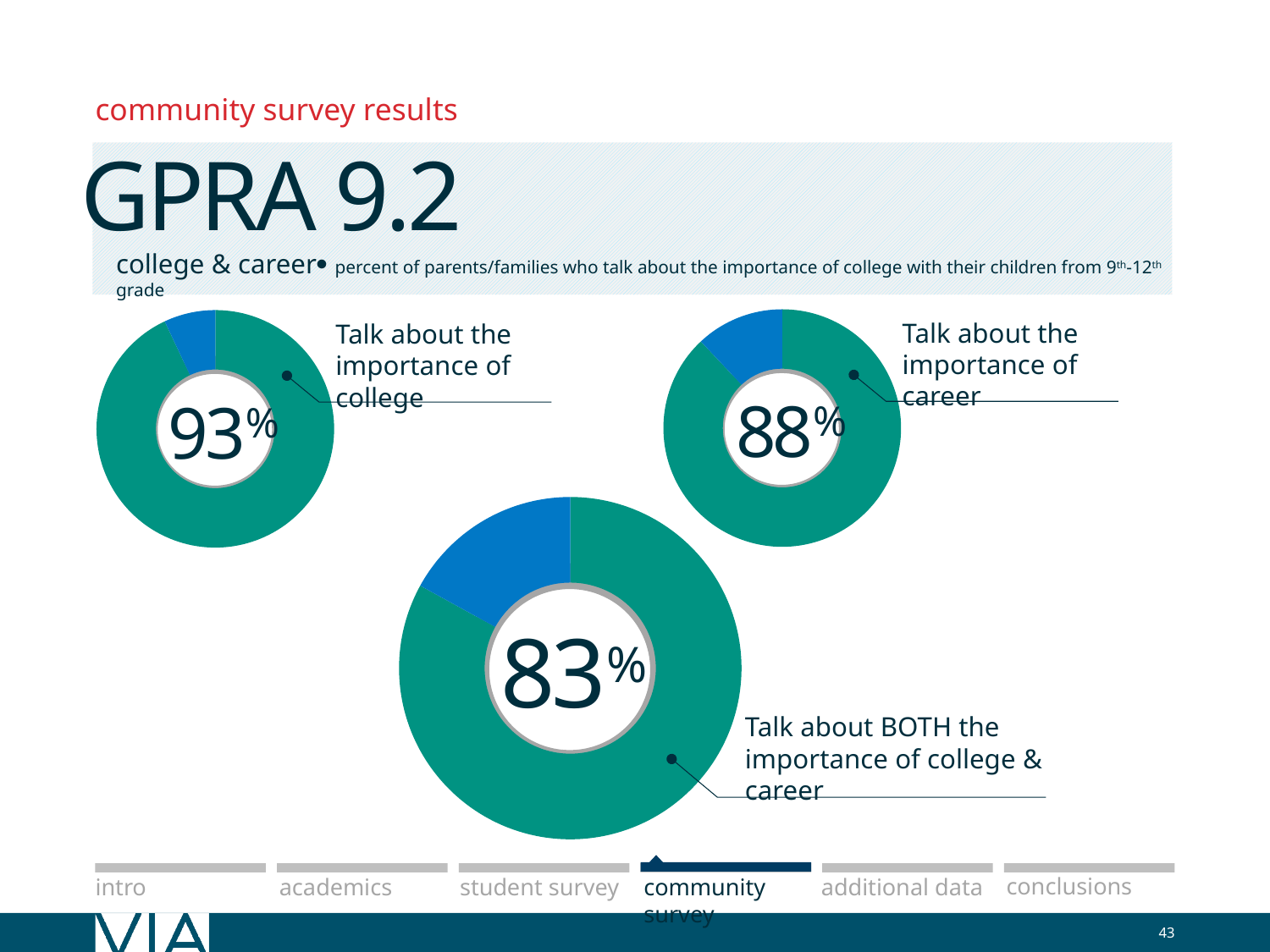
What kind of chart is used to show the survey results on this slide? Donut (pie) chart What percent of parents/families talk about BOTH the importance of college & career? 83% What percent of parents/families talk about the importance of college with their children? 93% Which is larger: the percentage who talk about the importance of college or the percentage who talk about the importance of career? Talk about the importance of college Which of the three donut charts shows the highest percentage? Talk about the importance of college What is the difference in percentage points between talking about the importance of career and talking about BOTH college & career? 5 Which of the three donut charts shows the lowest percentage? Talk about BOTH the importance of college & career What colour is the larger portion of each donut chart? Green What is the difference in percentage points between talking about the importance of college and talking about the importance of career? 5 What percent of parents/families talk about the importance of career with their children? 88% In the chart for talking about the importance of college, what share of the donut is the green portion? 93% How many donut charts are shown on the slide? 3